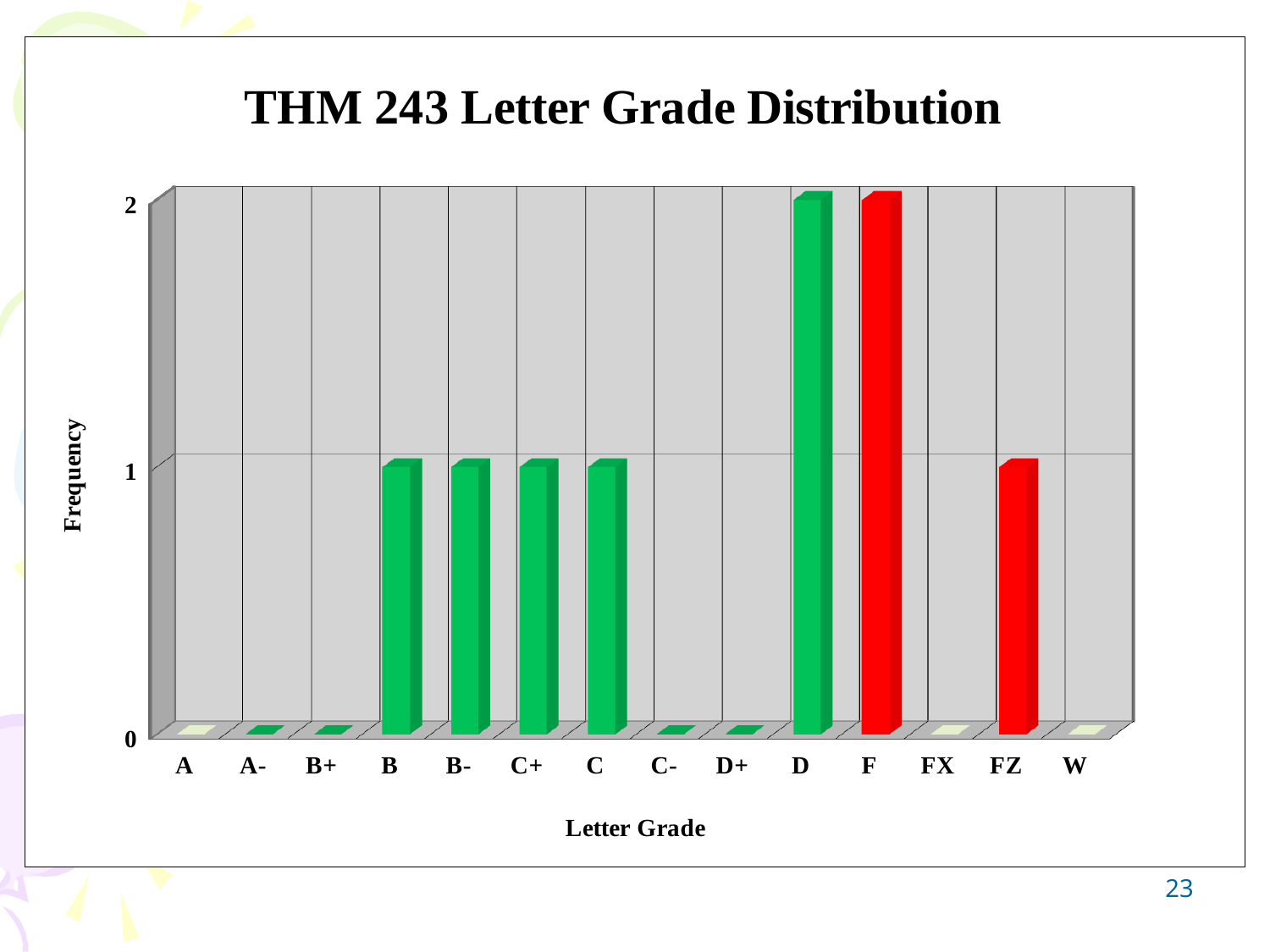
What is the title of the chart? THM 243 Letter Grade Distribution What type of chart is shown on the slide? bar chart What is the difference between the frequency for F and the frequency for FZ? 1 What is the frequency for letter grade A? 0 What is the frequency for letter grade D? 2 What is the label of the y axis? Frequency What is the frequency for letter grade B? 1 What is the total frequency for the grades B, B-, C+ and C combined? 4 Which has a higher frequency, D or C? D What is the frequency for letter grade F? 2 How many letter grade categories are shown on the x axis? 14 What is the frequency for letter grade FZ? 1